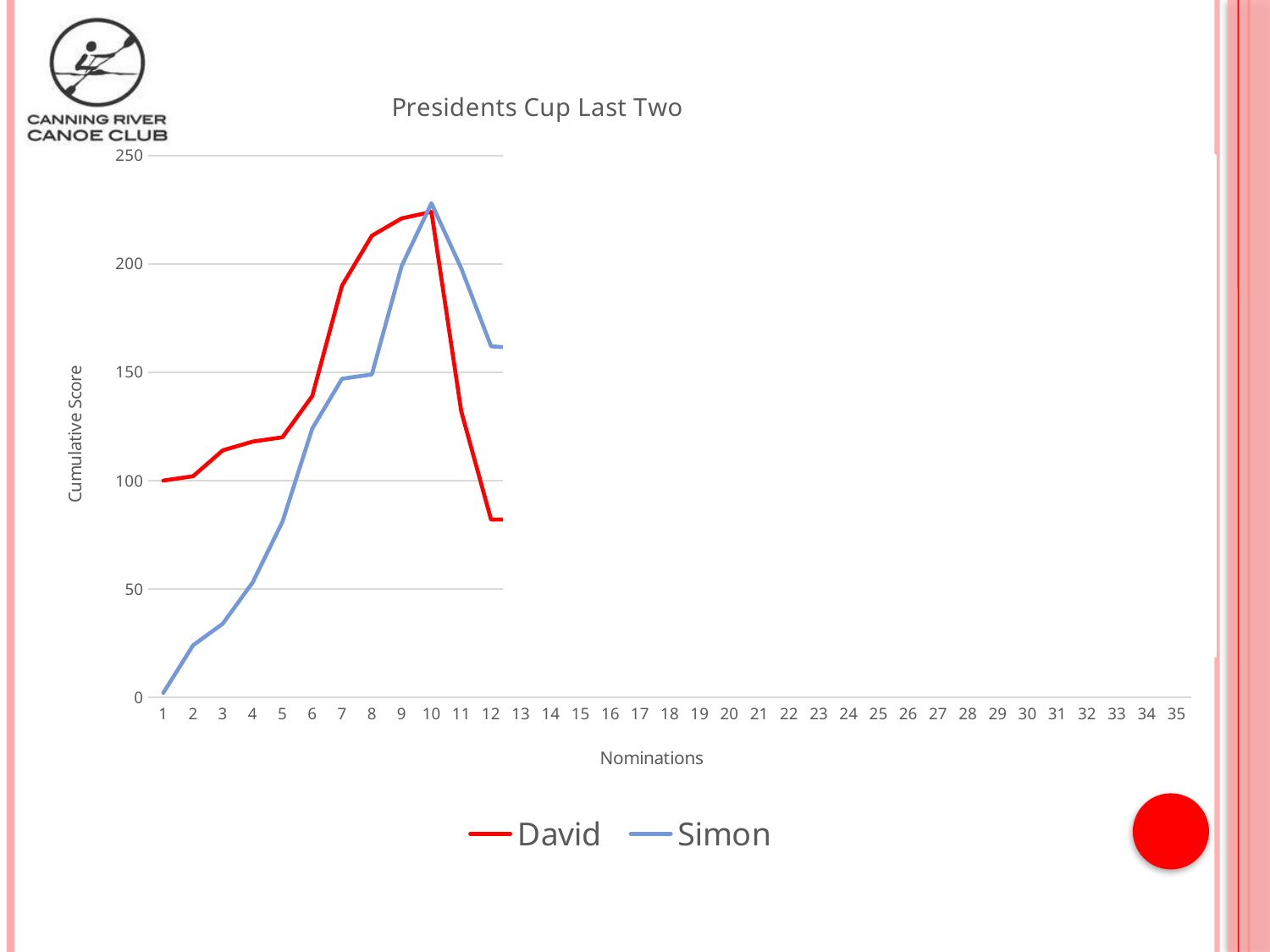
At nomination 12, which series has the higher cumulative score, David or Simon? Simon Is the value for Simon at nomination 12 greater or less than 150? greater Is the value for David at nomination 12 greater or less than 100? less How many series does the legend list? 2 Is the value for Simon at nomination 5 greater or less than 100? less Does David's cumulative score rise or fall from nomination 10 to nomination 12? fall At nomination 5, which series has the higher cumulative score, David or Simon? David What is the title of the chart? Presidents Cup Last Two What is the label of the y axis? Cumulative Score What kind of chart is shown on the slide? line chart